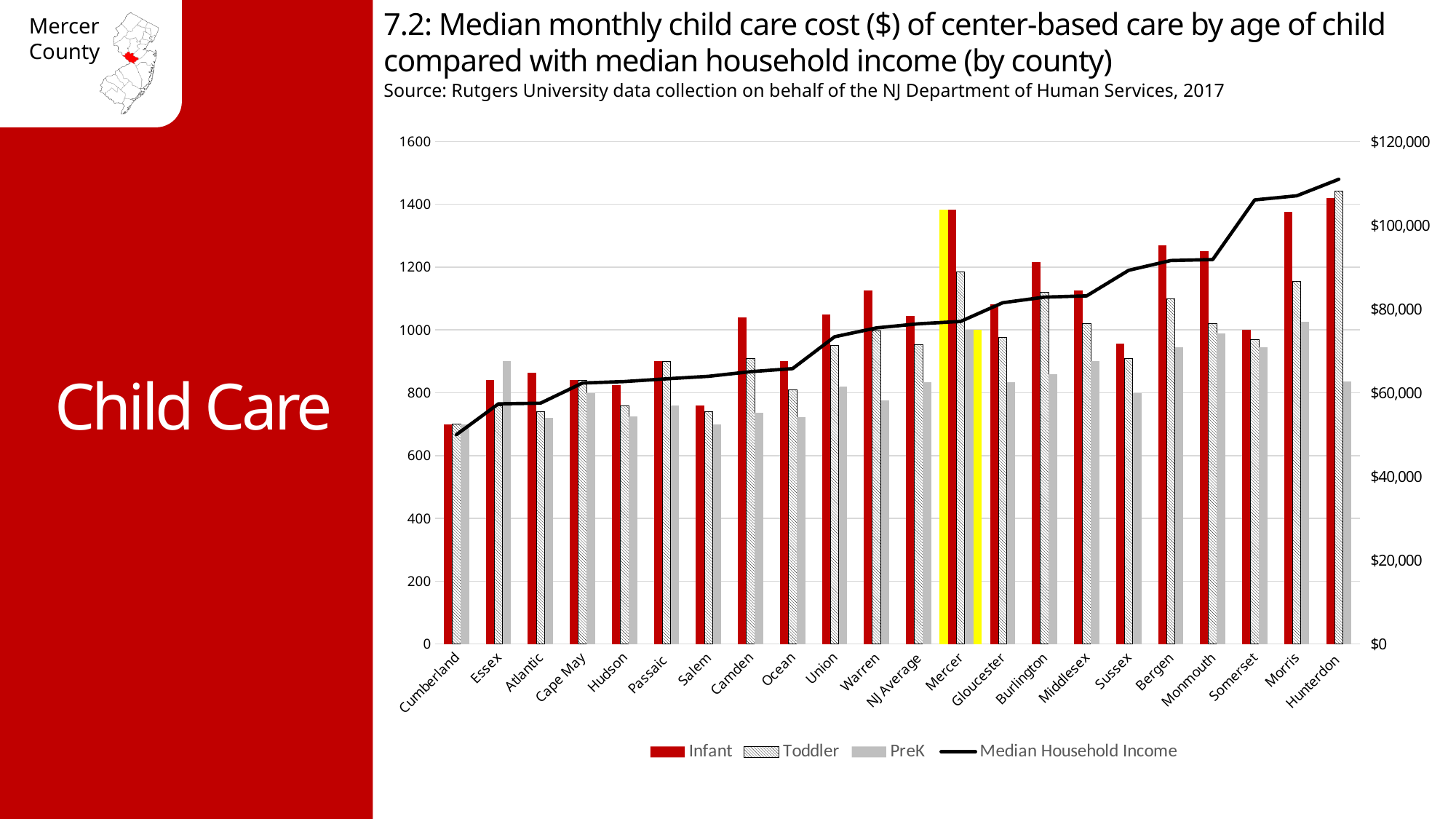
Which category has the lowest Infant value? Cumberland Is the Median Household Income for Hunterdon greater or less than $100,000? greater Which county's bars are highlighted in yellow? Mercer Is the Infant value for Mercer greater or less than 1200? greater Does the Median Household Income line generally rise or fall from Cumberland to Hunterdon? rise Is the Median Household Income for Cumberland greater or less than $60,000? less Which category has the highest Toddler value? Hunterdon What kind of chart is this? Bar chart with a line Which is larger, the Infant value for Mercer or the Infant value for Gloucester? Mercer How many counties or categories are shown along the x axis? 22 How many series does the legend list? 4